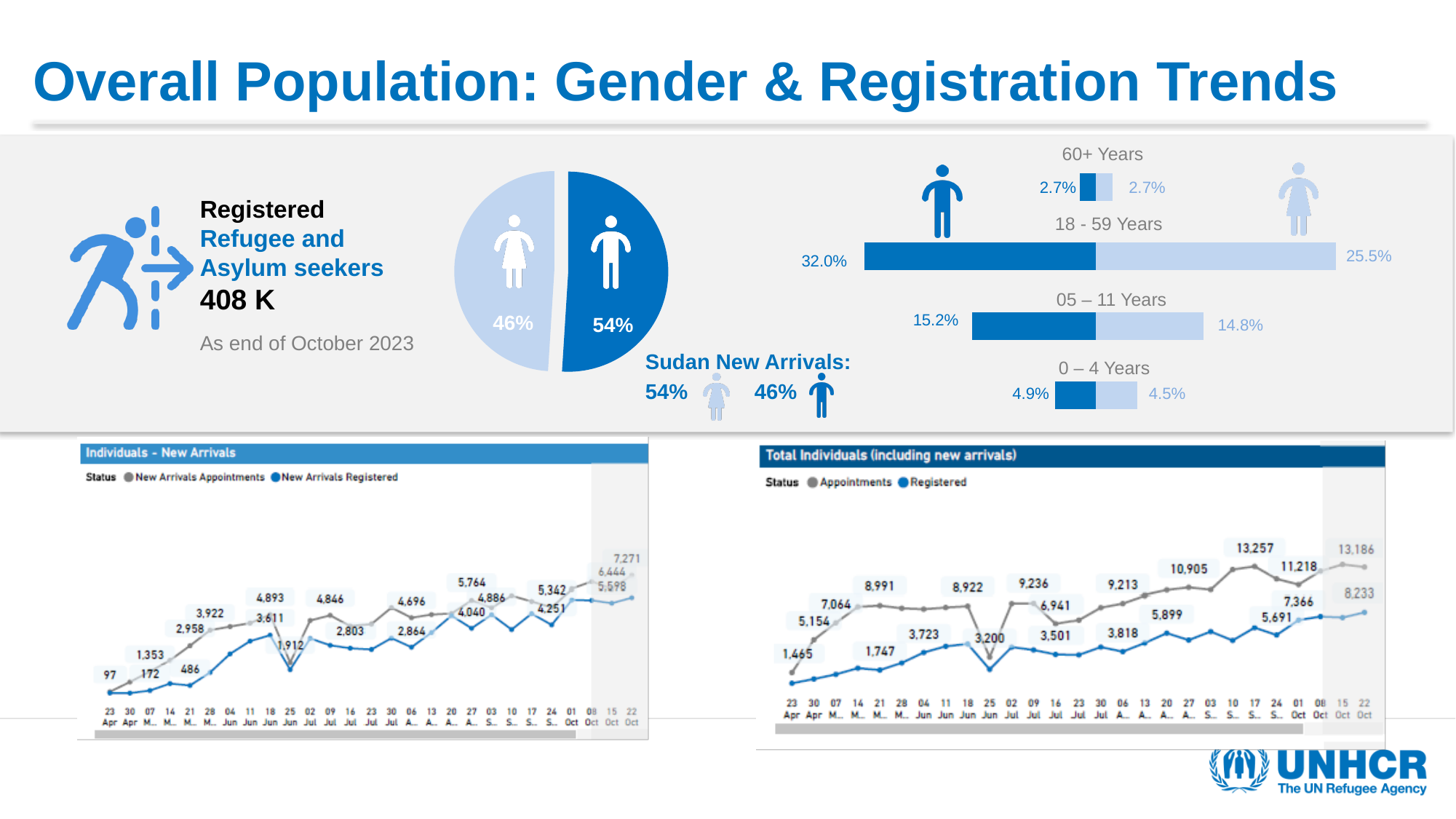
In the age breakdown chart, what is the difference between the male and female percentages for the 18 - 59 Years group? 6.5 percentage points In the 'Individuals - New Arrivals' chart, how many series does the legend list? 2 In the age breakdown chart, what is the male percentage for the 18 - 59 Years group? 32.0% In the age breakdown chart, how many age groups are shown? 4 In the 'Total Individuals (including new arrivals)' chart, what is the last labelled value for Registered on 22 Oct? 8,233 What kind of chart shows the 46% / 54% gender split? Pie chart In the pie chart, what share of the registered population is female? 46% In the age breakdown chart, what is the female percentage for the 0 – 4 Years group? 4.5% In the age breakdown chart, which age group has the largest share of the population? 18 - 59 Years In the 'Total Individuals (including new arrivals)' chart, what is the last labelled value for Appointments on 22 Oct? 13,186 In the 'Individuals - New Arrivals' chart, what is the first labelled value on 23 Apr? 97 In the pie chart, what share of the registered population is male? 54%